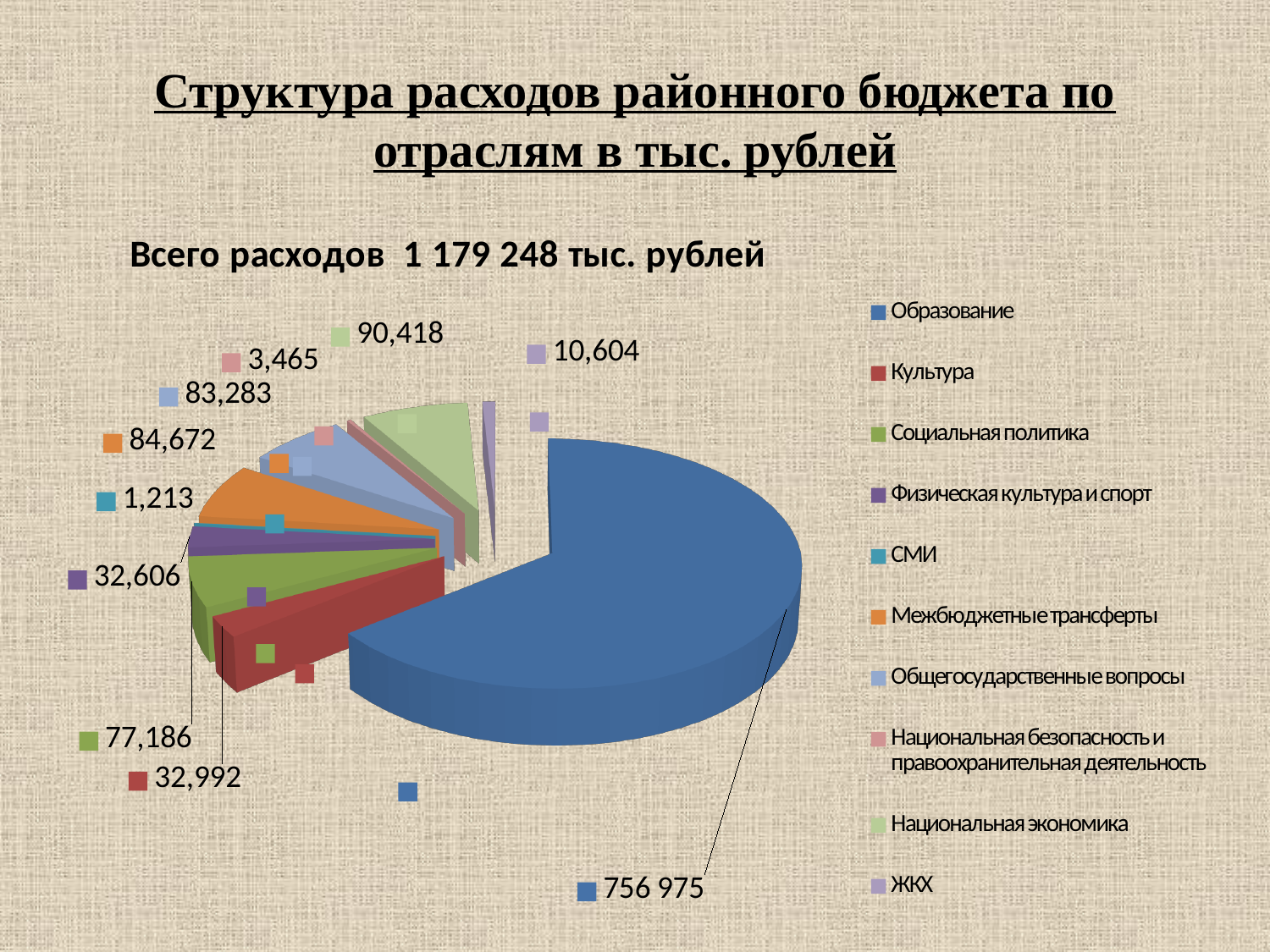
Which category has the largest share of the pie? Образование What is the value for СМИ? 1,213 What is the difference between Национальная экономика and Межбюджетные трансферты? 5,746 What kind of chart is shown on the slide? pie chart What is the value for Образование? 756 975 Which category has the smallest value? СМИ What is the value for Межбюджетные трансферты? 84,672 What is the value for Национальная экономика? 90,418 What is the value for ЖКХ? 10,604 Which is larger, Культура or Физическая культура и спорт? Культура How many categories does the pie chart have? 10 What total expenditure is stated above the chart? 1 179 248 тыс. рублей